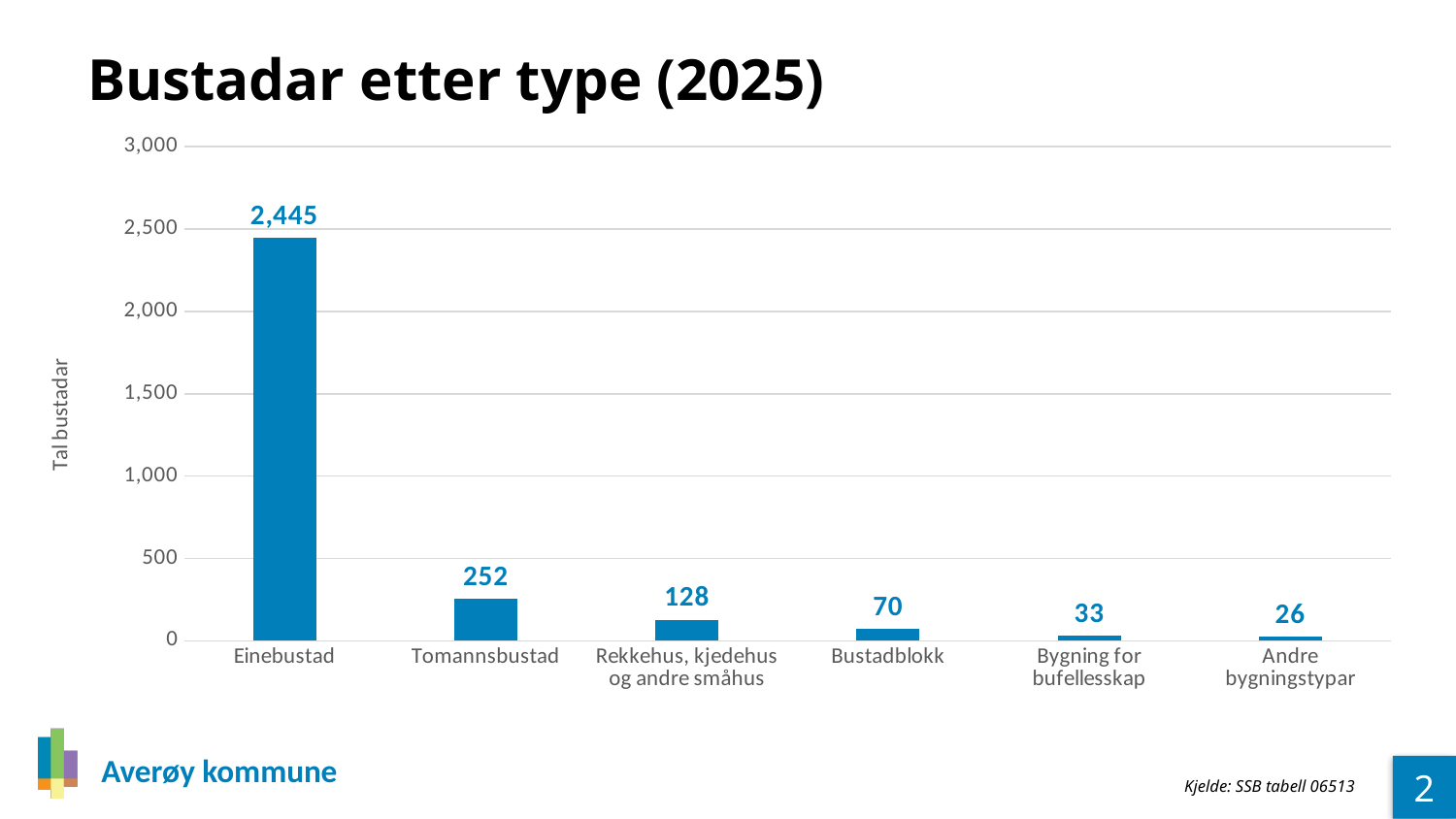
Which is larger, the value for Bustadblokk or the value for Bygning for bufellesskap? Bustadblokk What kind of chart is shown on the slide? bar chart What is the value for Andre bygningstypar? 26 Is the value for Einebustad greater or less than 2,000? greater Which category has the lowest value? Andre bygningstypar What is the value for Tomannsbustad? 252 Which category has the highest value? Einebustad What is the value for Bustadblokk? 70 What is the difference between the values for Tomannsbustad and Rekkehus, kjedehus og andre småhus? 124 How many categories are shown on the x axis? 6 What is the title of the chart? Bustadar etter type (2025) What is the value for Einebustad? 2,445